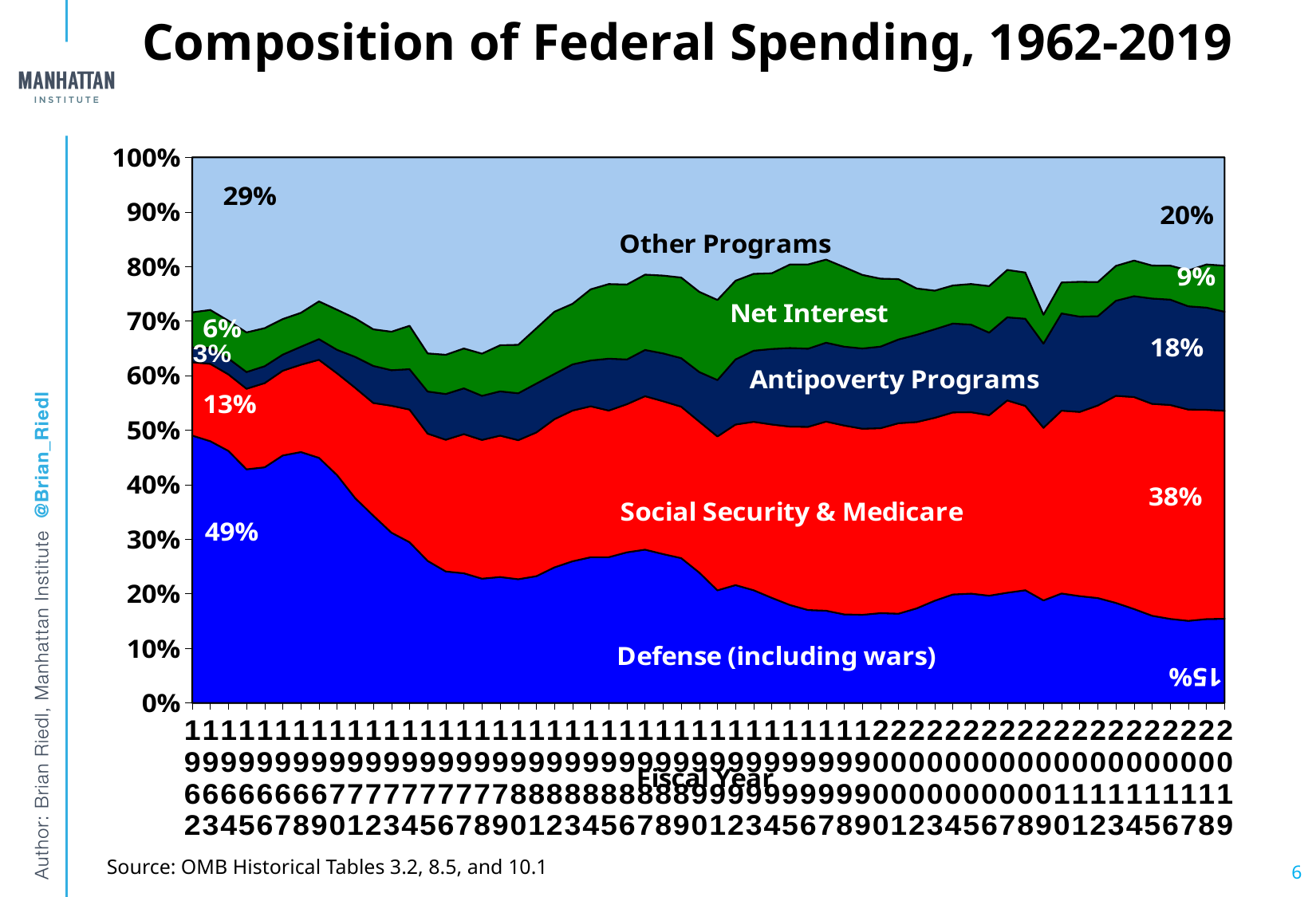
What share of federal spending did Net Interest account for in 1962? 6% Which spending category had the largest share of federal spending in 1962? Defense (including wars) Which was larger in 2019: the share for Other Programs or the share for Antipoverty Programs? Other Programs Which spending category had the smallest share of federal spending in 1962? Antipoverty Programs How does the Defense (including wars) share of federal spending change from 1962 to 2019? It falls What share of federal spending did Other Programs account for in 1962? 29% What share of federal spending did Antipoverty Programs account for in 2019? 18% By how many percentage points did the Social Security & Medicare share change between 1962 (13%) and 2019 (38%)? 25 percentage points How many spending categories are stacked in the chart? 5 What share of federal spending did Social Security & Medicare account for in 2019? 38% What type of chart is shown on the slide? Stacked area chart What share of federal spending did Defense (including wars) account for in 1962? 49%